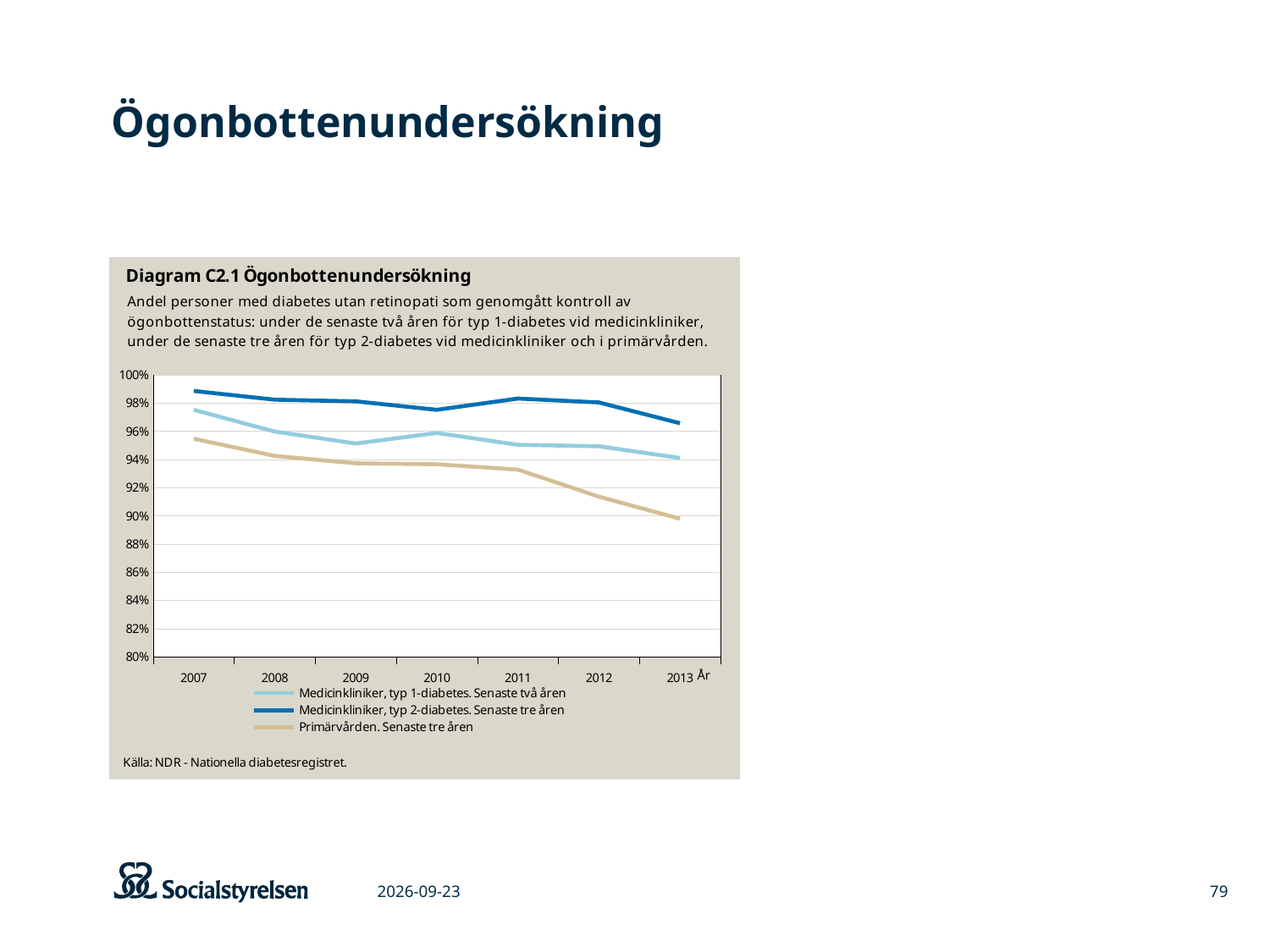
How many series does the legend of Diagram C2.1 list? 3 How many years are plotted along the x axis of Diagram C2.1? 7 Is the value for Primärvården. Senaste tre åren in 2012 greater or less than 92%? less Which series has the lowest value in 2013? Primärvården. Senaste tre åren What is the title of the diagram on the slide? Diagram C2.1 Ögonbottenundersökning Is the value for Medicinkliniker, typ 2-diabetes. Senaste tre åren in 2007 greater or less than 98%? greater Is the value for Medicinkliniker, typ 2-diabetes. Senaste tre åren in 2013 greater or less than 98%? less What source is cited below the chart? NDR - Nationella diabetesregistret In 2010, which is larger: the value for Medicinkliniker, typ 1-diabetes. Senaste två åren or the value for Primärvården. Senaste tre åren? Medicinkliniker, typ 1-diabetes. Senaste två åren Does the value for Primärvården. Senaste tre åren rise or fall from 2007 to 2013? fall What kind of chart is shown in Diagram C2.1? line chart Which series has the highest value in 2013? Medicinkliniker, typ 2-diabetes. Senaste tre åren